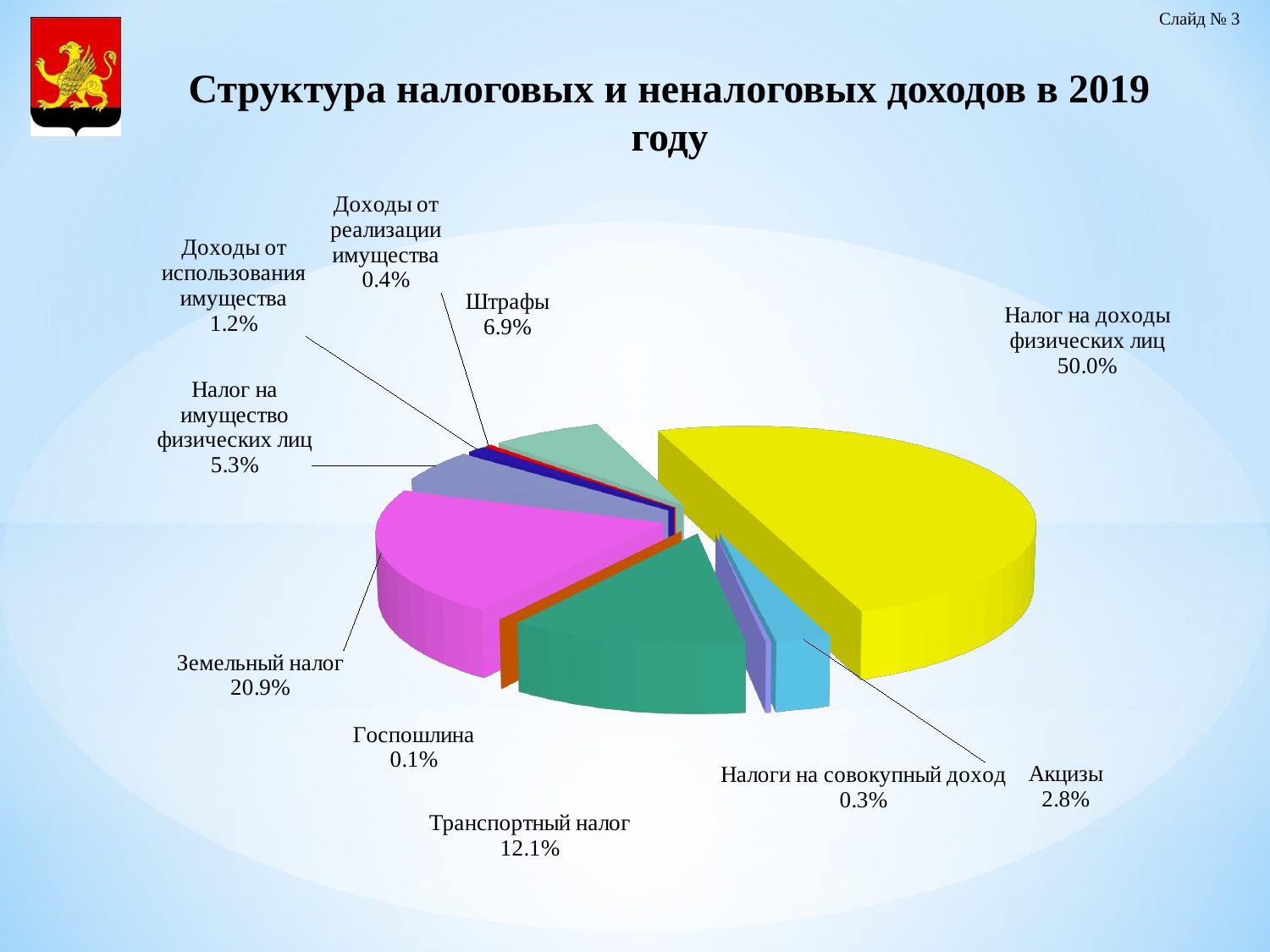
Сколько категорий показано на диаграмме? 10 Какой тип диаграммы показан на слайде? Круговая диаграмма Какова доля категории «Штрафы»? 6.9% Какая категория имеет наименьшую долю на диаграмме? Госпошлина Какова доля категории «Доходы от использования имущества»? 1.2% Какая категория имеет наибольшую долю на диаграмме? Налог на доходы физических лиц Какова доля категории «Налог на доходы физических лиц» на диаграмме? 50.0% Как называется диаграмма на слайде? Структура налоговых и неналоговых доходов в 2019 году Что больше: доля «Акцизов» или доля «Налога на имущество физических лиц»? Налог на имущество физических лиц На сколько процентных пунктов доля «Земельного налога» больше доли «Транспортного налога»? 8.8 Какова доля категории «Земельный налог»? 20.9% Какова доля категории «Транспортный налог»? 12.1%